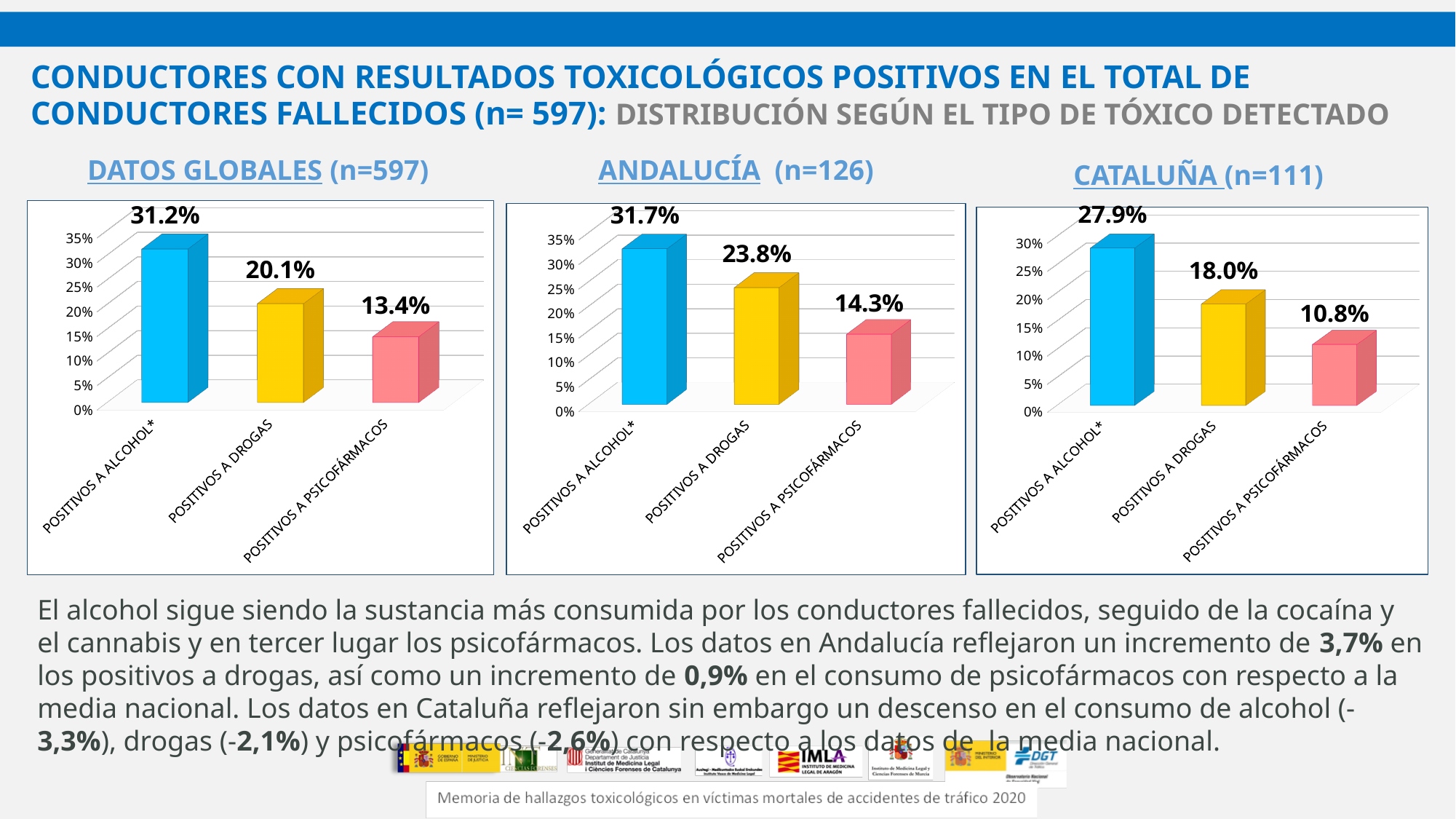
In the DATOS GLOBALES chart, what is the value for POSITIVOS A ALCOHOL*? 31.2% In the DATOS GLOBALES chart, what is the difference between POSITIVOS A ALCOHOL* and POSITIVOS A DROGAS? 11.1% How many categories are shown in the DATOS GLOBALES chart? 3 In the ANDALUCÍA chart, which category has the lowest value? POSITIVOS A PSICOFÁRMACOS In the ANDALUCÍA chart, is the value for POSITIVOS A ALCOHOL* greater or less than 30%? greater In the CATALUÑA chart, which category has the highest value? POSITIVOS A ALCOHOL* In the CATALUÑA chart, what is the value for POSITIVOS A PSICOFÁRMACOS? 10.8% Which is larger: POSITIVOS A DROGAS in the ANDALUCÍA chart or POSITIVOS A DROGAS in the CATALUÑA chart? ANDALUCÍA In the ANDALUCÍA chart, do the values rise or fall from left to right along the x axis? fall In the ANDALUCÍA chart, what is the value for POSITIVOS A DROGAS? 23.8% In the CATALUÑA chart, what is the difference between POSITIVOS A DROGAS and POSITIVOS A PSICOFÁRMACOS? 7.2% What kind of chart is the CATALUÑA chart? bar chart